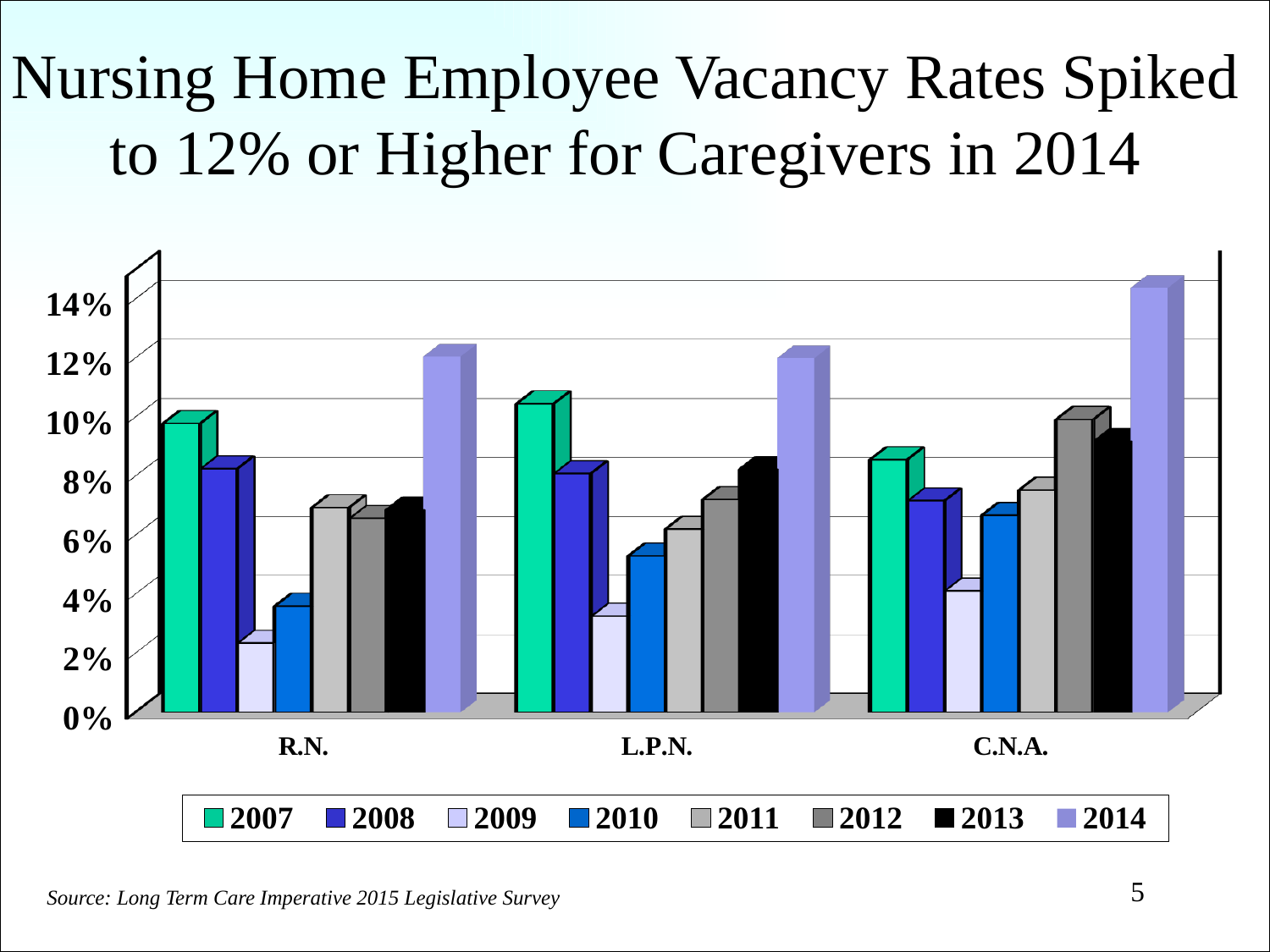
For R.N., which year has the lowest vacancy rate? 2009 For R.N., which is larger: the 2007 vacancy rate or the 2008 vacancy rate? 2007 Is the 2013 vacancy rate for C.N.A. greater or less than 8%? greater How many job categories are shown on the x axis? 3 Is the 2009 vacancy rate for R.N. greater or less than 4%? less For C.N.A., which year has the highest vacancy rate? 2014 What kind of chart is shown on the slide? bar chart What is the title of the chart on the slide? Nursing Home Employee Vacancy Rates Spiked to 12% or Higher for Caregivers in 2014 How many series (years) does the legend list? 8 For R.N., which year has the highest vacancy rate? 2014 Is the 2014 vacancy rate for C.N.A. greater or less than 12%? greater